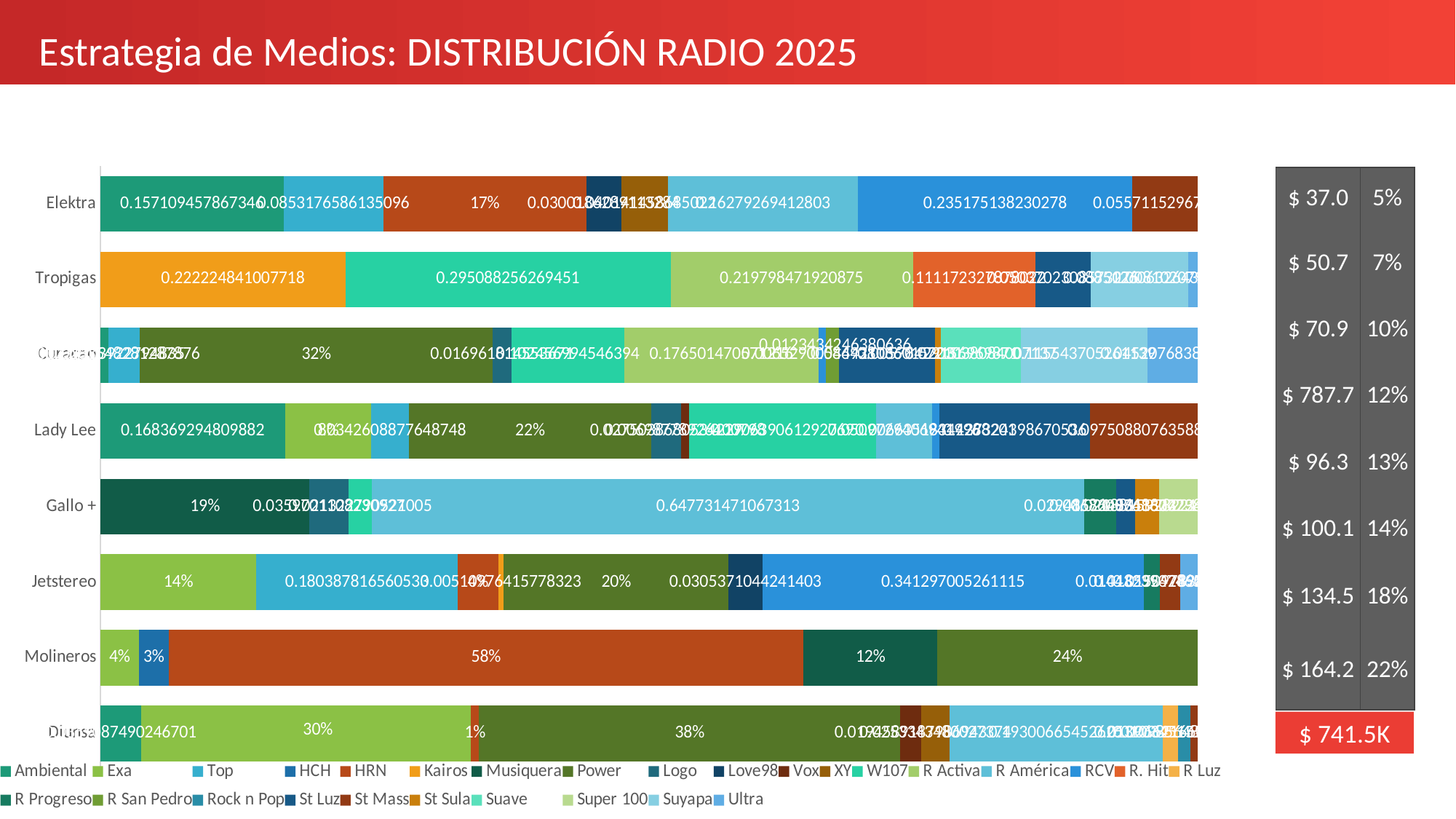
What is the HRN share for Molineros? 58% What is the Power share for Molineros? 24% What is the Power share for Diunsa? 38% For Molineros, what is the difference between the Power share and the Musiquera share? 12% How many companies (categories) are plotted on the chart? 8 What kind of chart is shown on the slide? Stacked bar chart What is the RCV value for Jetstereo? 0.341297005261115 For Molineros, which is larger: the Power share or the Musiquera share? Power How many series does the legend list? 28 Which station has the largest share of the Molineros bar? HRN